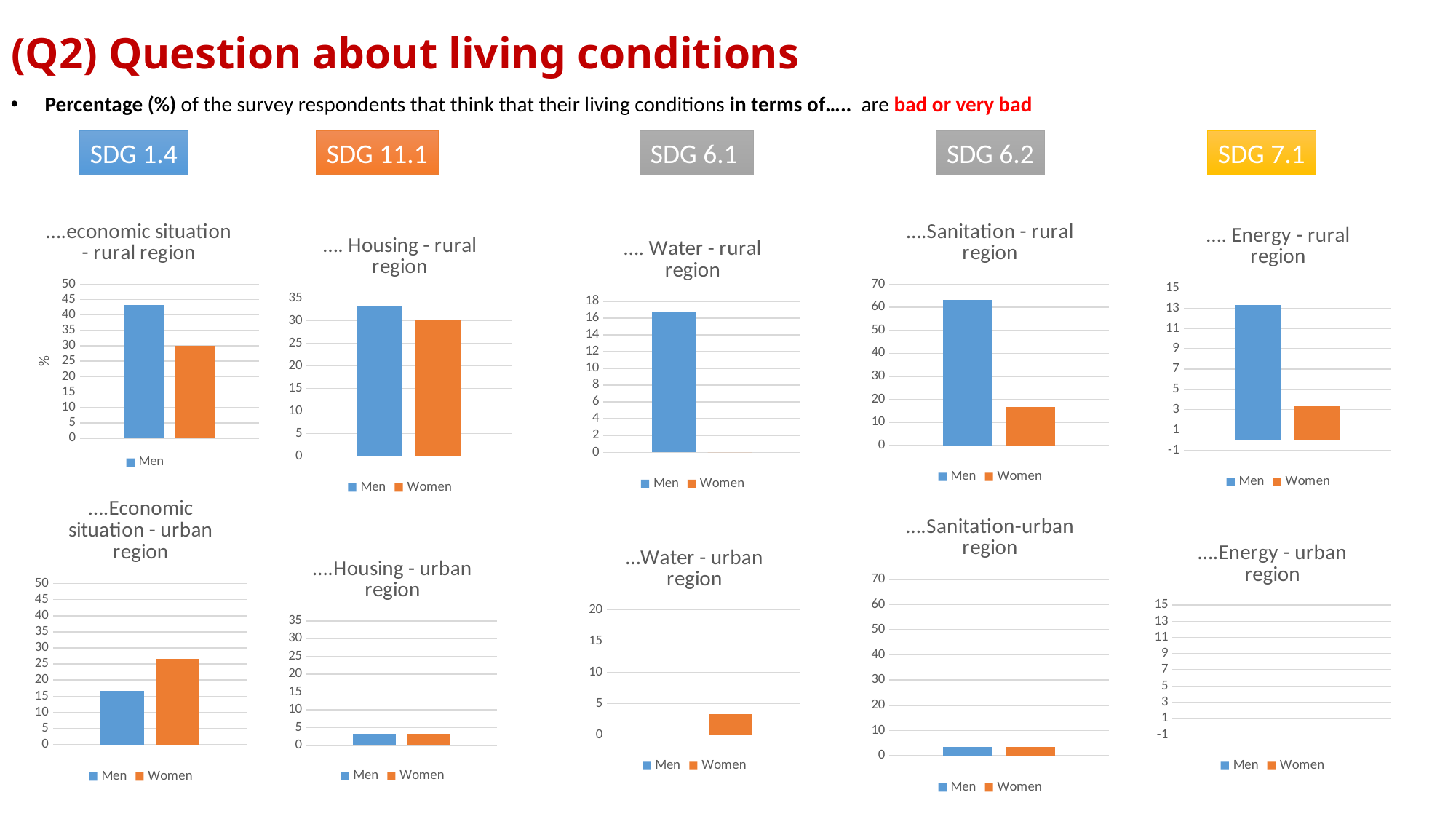
In the '....Economic situation - urban region' chart, is the value for Women greater or less than 20? greater In the '....Economic situation - urban region' chart, which bar is taller, Men or Women? Women In the '....economic situation - rural region' chart, which bar is taller, Men or Women? Men How many series does the legend of the '…. Housing - rural region' chart list? 2 In the '....Sanitation - rural region' chart, is the value for Women greater or less than 20? less In the '....Sanitation - rural region' chart, is the value for Men greater or less than 60? greater What kind of chart is the '....Sanitation-urban region' chart? bar chart